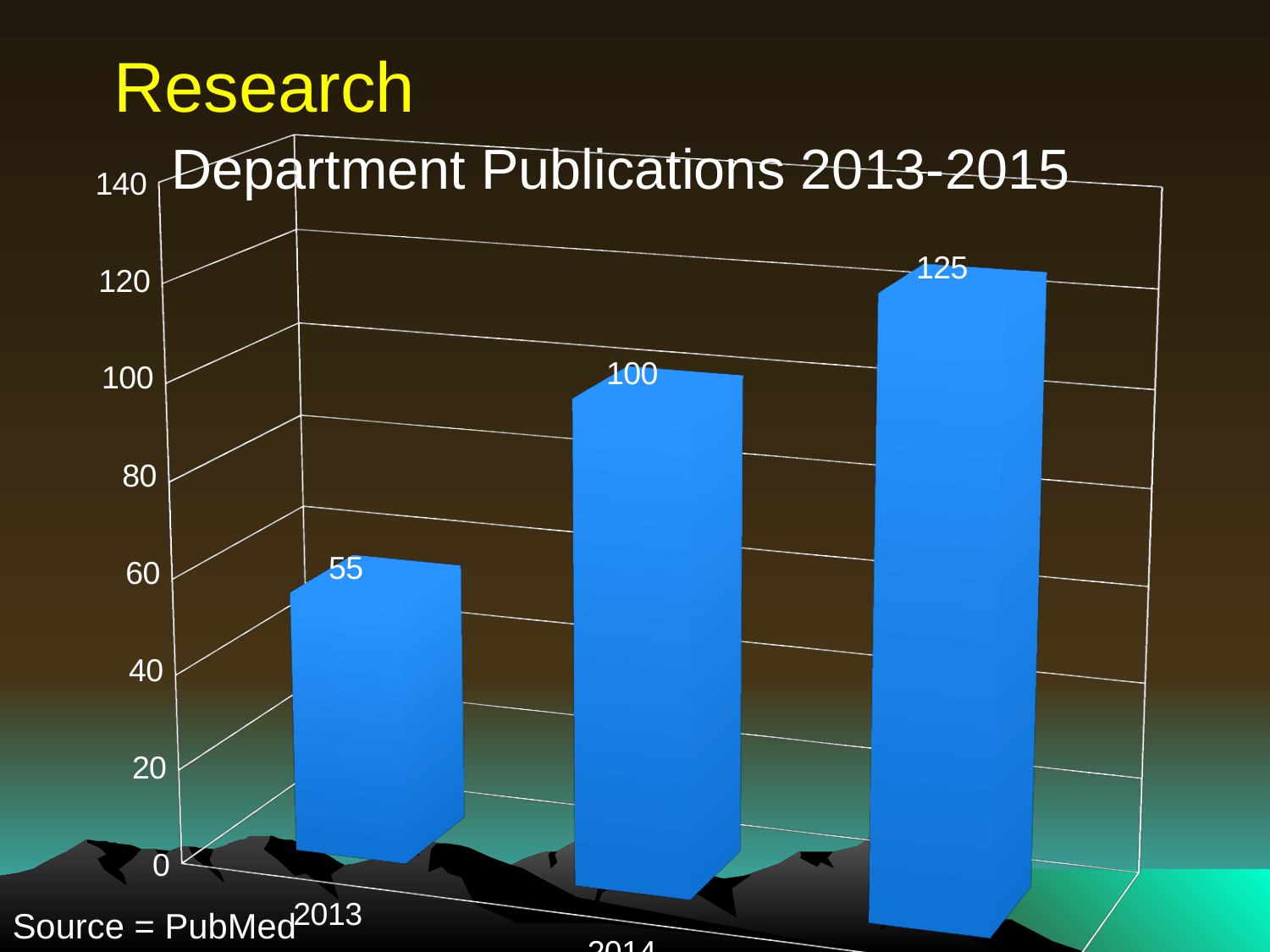
Which bar has the lowest value? 2013 Which bar has the highest value, the leftmost, middle or rightmost? rightmost How many bars are plotted in the chart? 3 Is the value for 2013 greater or less than 60? less What is the value of the middle bar in the chart? 100 What is the difference between the rightmost bar and the 2013 bar? 70 Which is larger, the 2013 bar or the middle bar? the middle bar What is the value of the rightmost bar in the chart? 125 What kind of chart is shown on the slide? bar chart What is the value of the bar for 2013? 55 Do the values rise or fall from left to right across the chart? rise What is the difference between the middle bar and the 2013 bar? 45